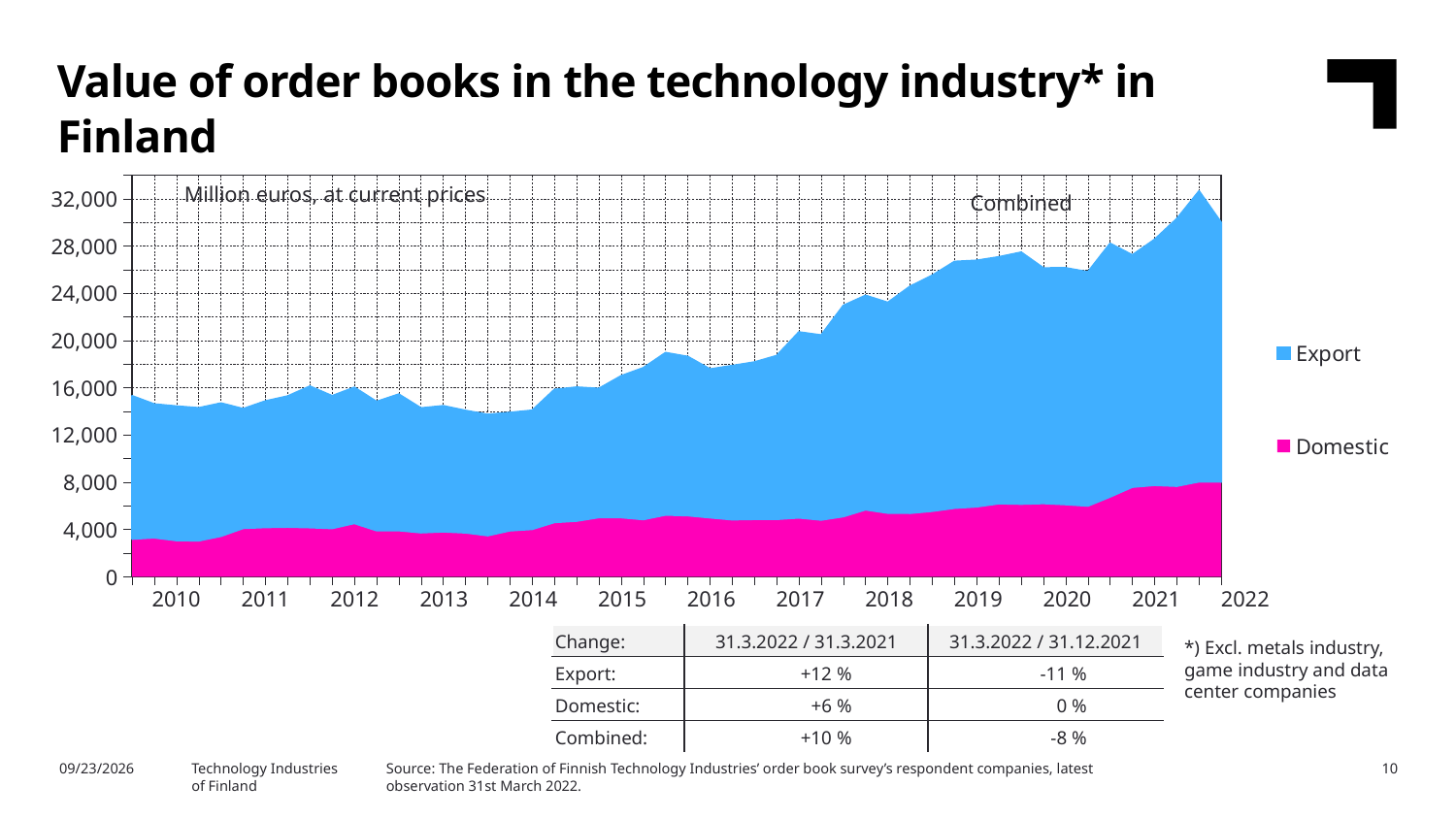
Does the combined value of order books generally rise or fall from 2010 to 2022? rise Is the combined value of order books at the start of 2010 greater or less than 16,000? less What unit is stated for the values in the chart? Million euros, at current prices Is the combined value of order books at the start of 2022 greater or less than 28,000? greater What kind of chart is shown on the slide? Stacked area chart How many series does the chart's legend list? 2 Is the combined value of order books at the start of 2016 greater or less than 16,000? greater Which series is larger throughout the chart, Export or Domestic? Export How many year labels are shown on the x axis of the chart? 13 Which two series are listed in the chart's legend? Export and Domestic